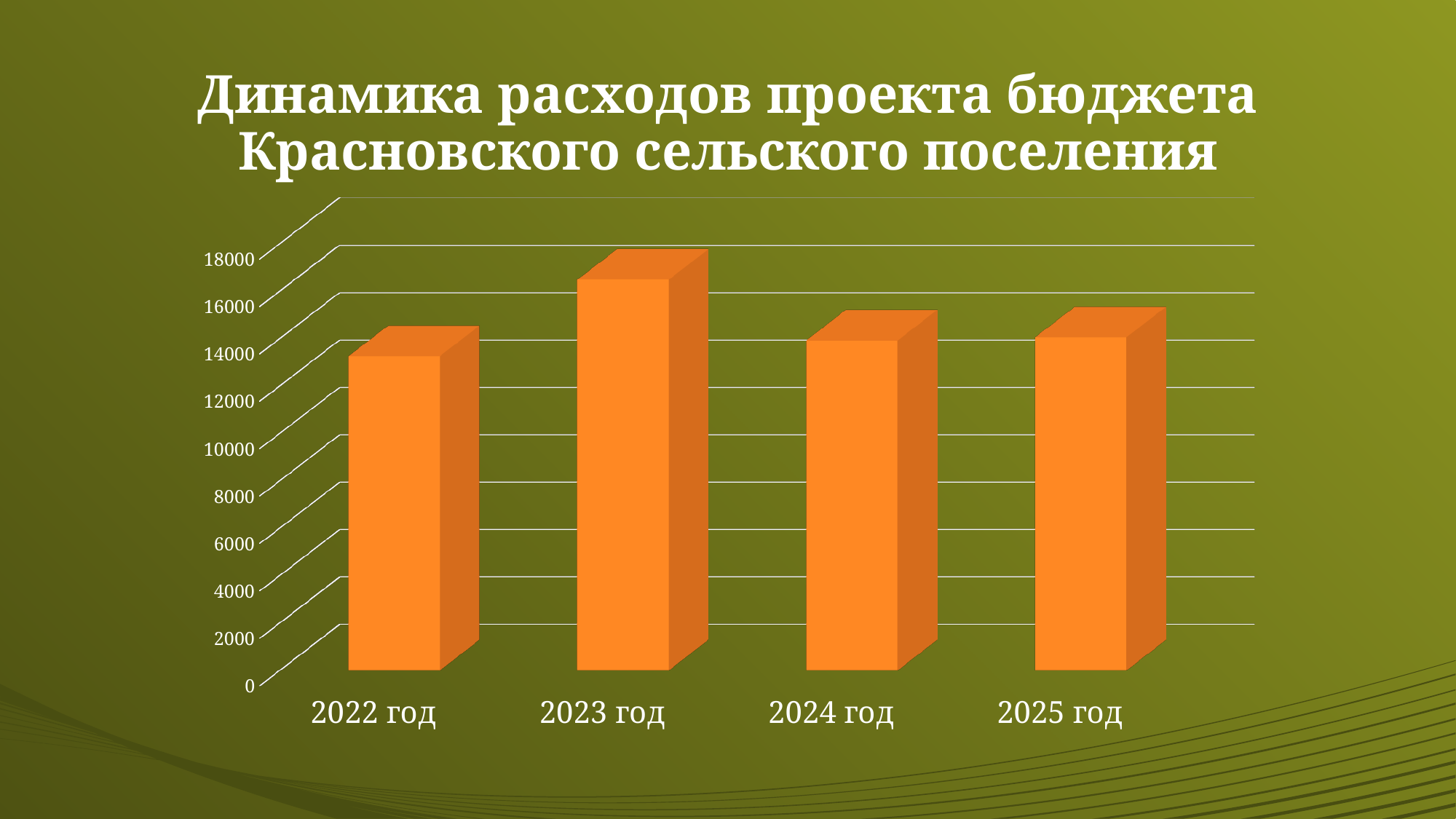
What colour are the bars in the chart? orange How many years (categories) are shown on the x axis? 4 Which is larger, the value for 2022 год or the value for 2024 год? 2024 год What kind of chart is shown on the slide? bar chart Which year has the lowest expenditure value? 2022 год Which year has the highest expenditure value? 2023 год Is the value for 2022 год greater or less than 12000? greater Is the value for 2023 год greater or less than 16000? greater What is the title of the chart? Динамика расходов проекта бюджета Красновского сельского поселения Is the value for 2025 год greater or less than 12000? greater Which is larger, the value for 2022 год or the value for 2023 год? 2023 год